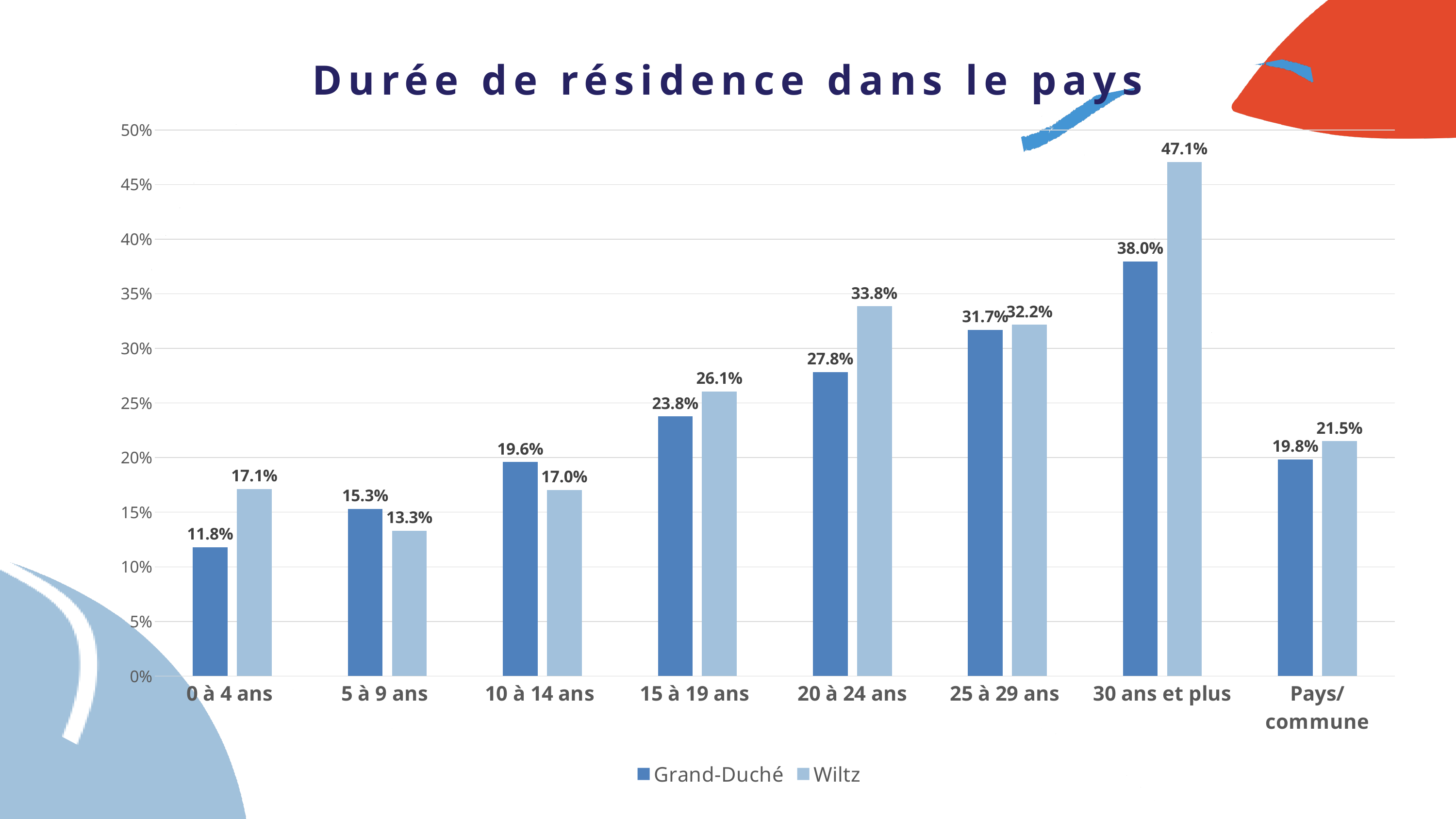
Which category has the lowest Wiltz value? 5 à 9 ans What is the Grand-Duché value for the '0 à 4 ans' category? 11.8% Which category has the highest Grand-Duché value? 30 ans et plus What kind of chart is shown on the slide? bar chart How many series does the legend list? 2 Is the Wiltz value for '20 à 24 ans' greater or less than 30%? greater How many categories are shown on the x axis? 8 Which is larger for '10 à 14 ans': the Grand-Duché value or the Wiltz value? Grand-Duché What is the title of the chart? Durée de résidence dans le pays What is the difference between the Wiltz and Grand-Duché values for '30 ans et plus'? 9.1% What is the Wiltz value for the '30 ans et plus' category? 47.1% What is the Wiltz value for the '5 à 9 ans' category? 13.3%